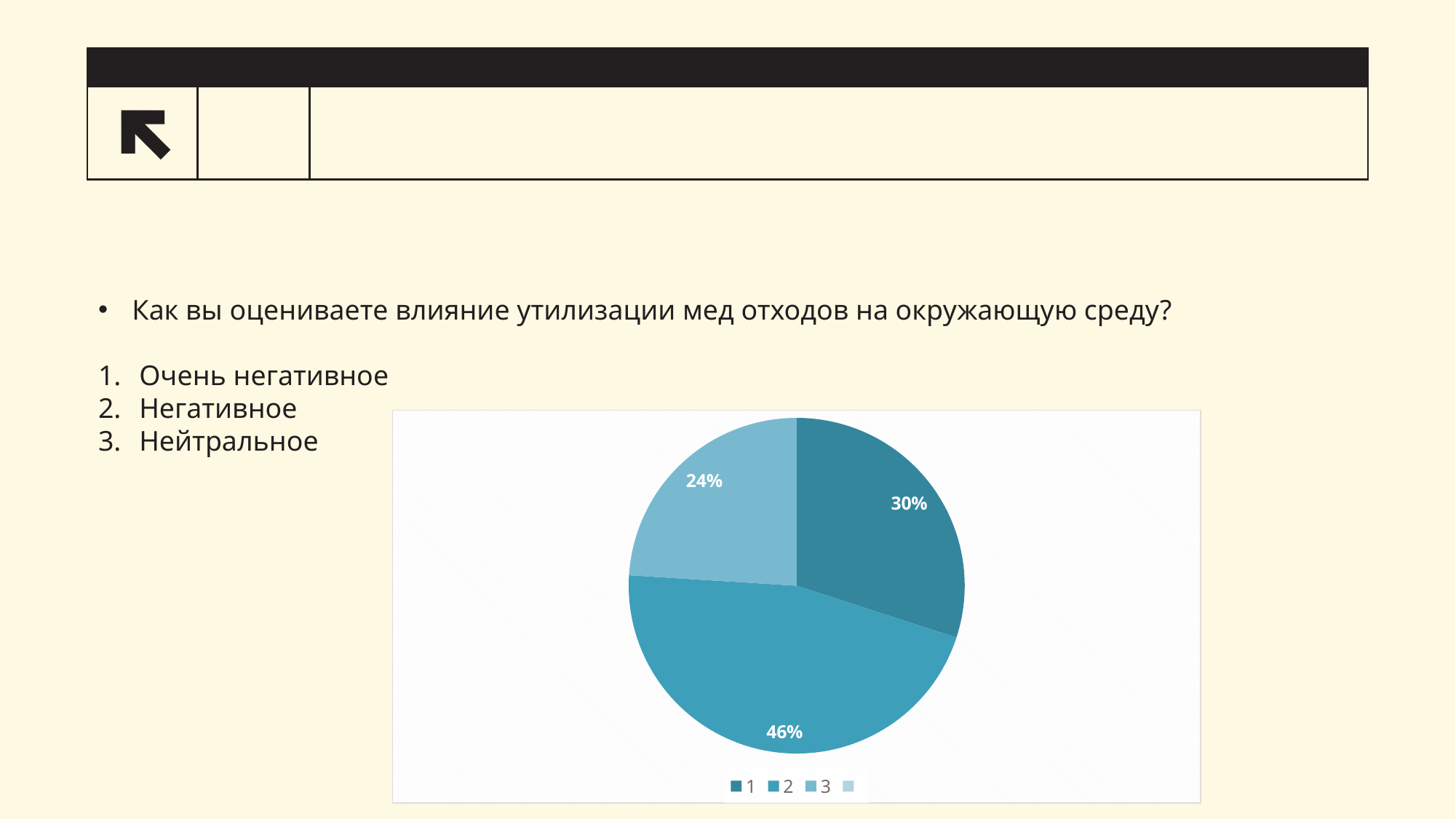
Which is larger, the slice for category 1 or the slice for category 3? 1 What kind of chart is shown on the slide? pie chart Which category has the smallest slice of the pie? 3 How many slices are shown in the pie chart? 3 What share of the pie does category 2 have? 46% Which category has the largest slice of the pie? 2 Which answer option corresponds to category 2 in the pie chart? Негативное What is the difference between the shares of category 1 and category 3? 6% What survey question does the pie chart illustrate? Как вы оцениваете влияние утилизации мед отходов на окружающую среду? What share of the pie does category 3 have? 24% What share of the pie does category 1 have? 30% What is the difference between the shares of category 2 and category 1? 16%